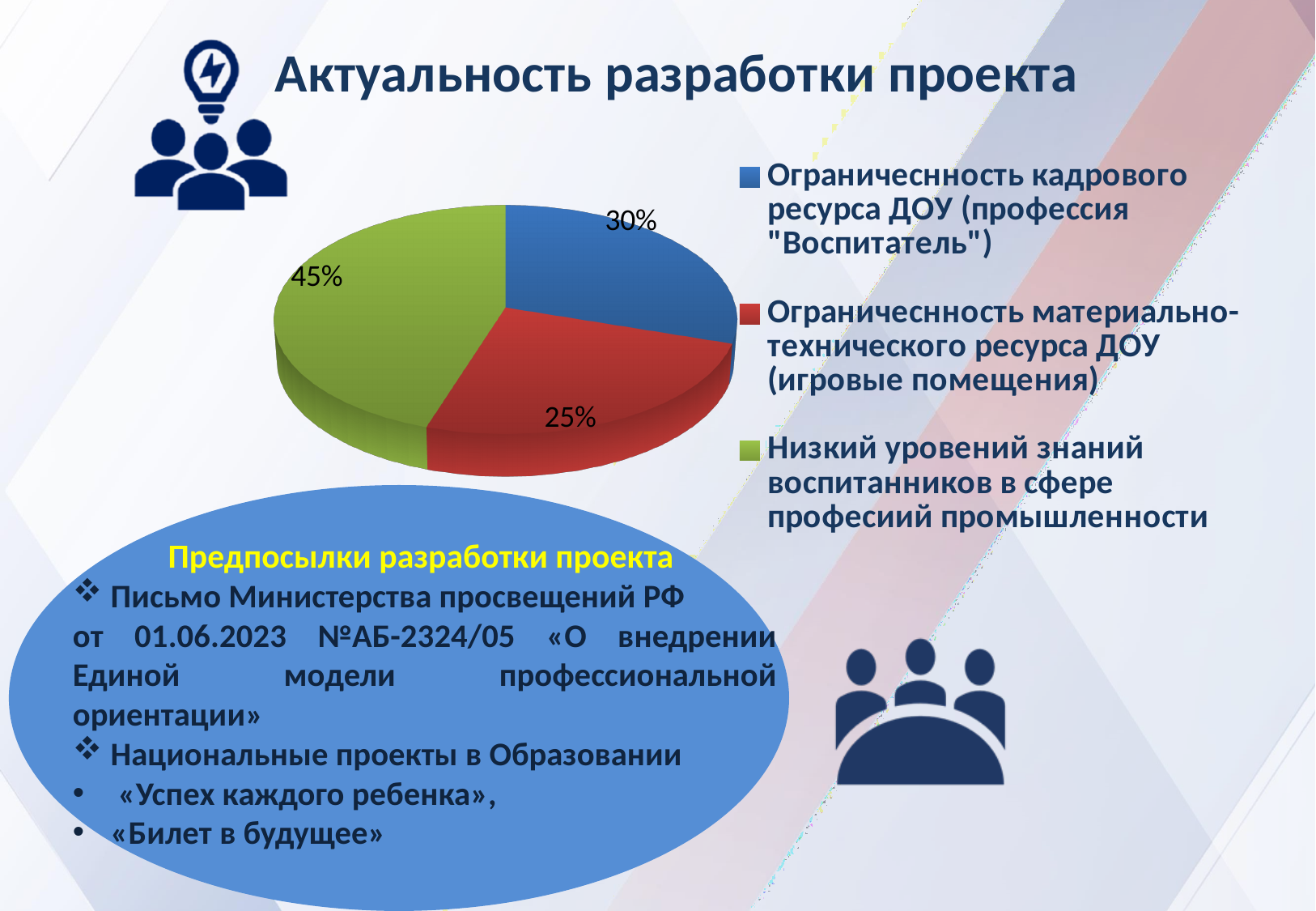
What share of the pie is labelled for "Ограничесность материально-технического ресурса ДОУ (игровые помещения)"? 25% How many slices does the pie chart have? 3 What kind of chart is shown on the slide? Pie chart Which is larger: the slice for "Ограничесность кадрового ресурса ДОУ" or the slice for "Ограничесность материально-технического ресурса ДОУ"? Ограничесность кадрового ресурса ДОУ What colour is the slice representing 45%? Green What share of the pie is labelled for "Ограничесность кадрового ресурса ДОУ (профессия "Воспитатель")"? 30% What share of the pie is labelled for "Низкий уровений знаний воспитанников в сфере професиий промышленности"? 45% What colour is the slice representing 25%? Red What is the difference in percentage points between the green slice (45%) and the blue slice (30%)? 15 Which category has the largest slice of the pie? Низкий уровений знаний воспитанников в сфере професиий промышленности How many entries does the pie chart's legend list? 3 Which category has the smallest slice of the pie? Ограничесность материально-технического ресурса ДОУ (игровые помещения)